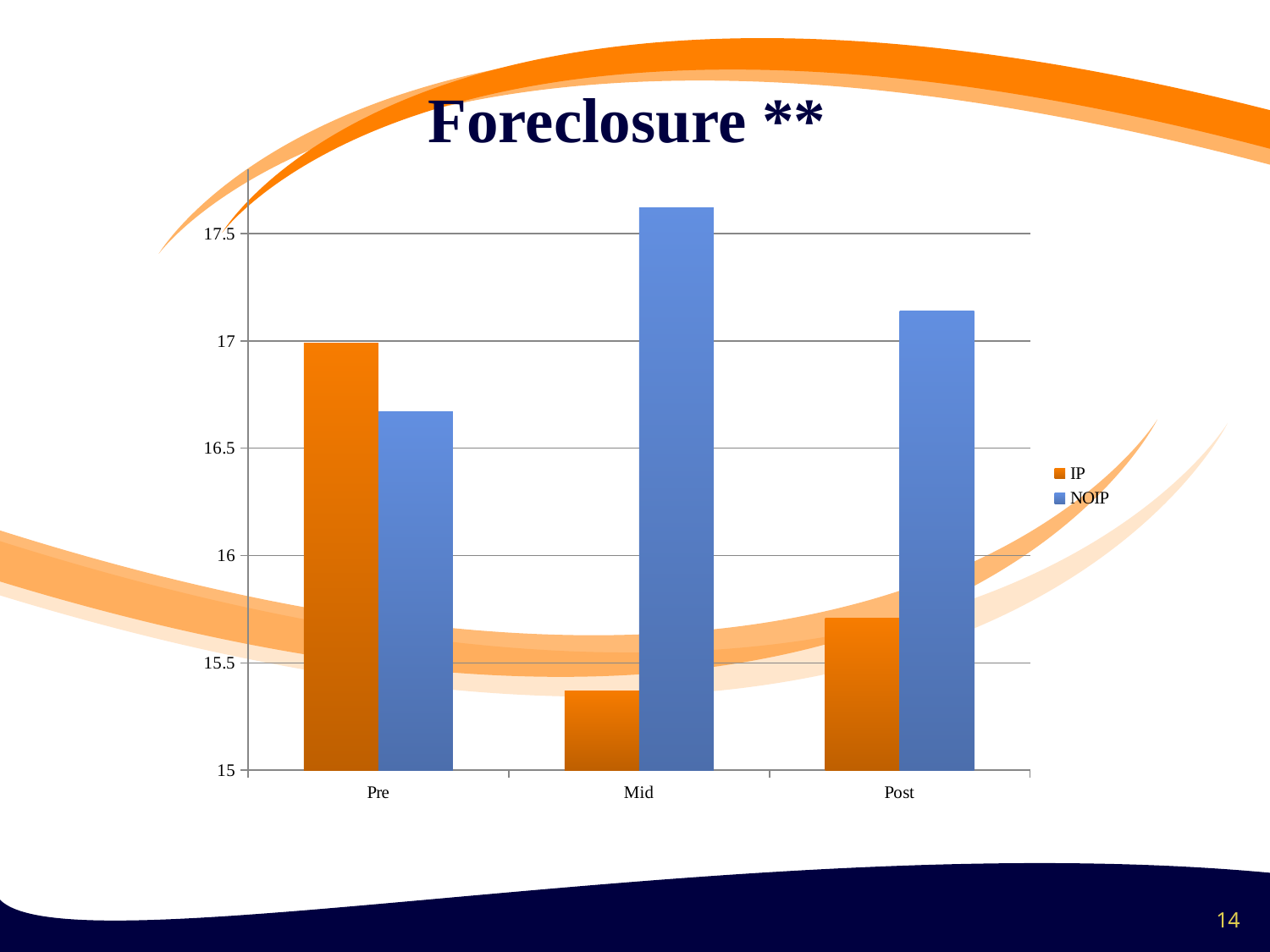
In the Mid category, which series has the larger value, IP or NOIP? NOIP Is the IP value for Post greater or less than 16? less How many categories are shown on the x axis? 3 Which category has the highest NOIP value? Mid Which category has the lowest NOIP value? Pre In the Pre category, which series has the larger value, IP or NOIP? IP How many series does the legend list? 2 What is the title of the chart? Foreclosure ** Which category has the lowest IP value? Mid Is the NOIP value for Post greater or less than 17? greater Is the IP value for Mid greater or less than 15.5? less What kind of chart is shown on the slide? bar chart